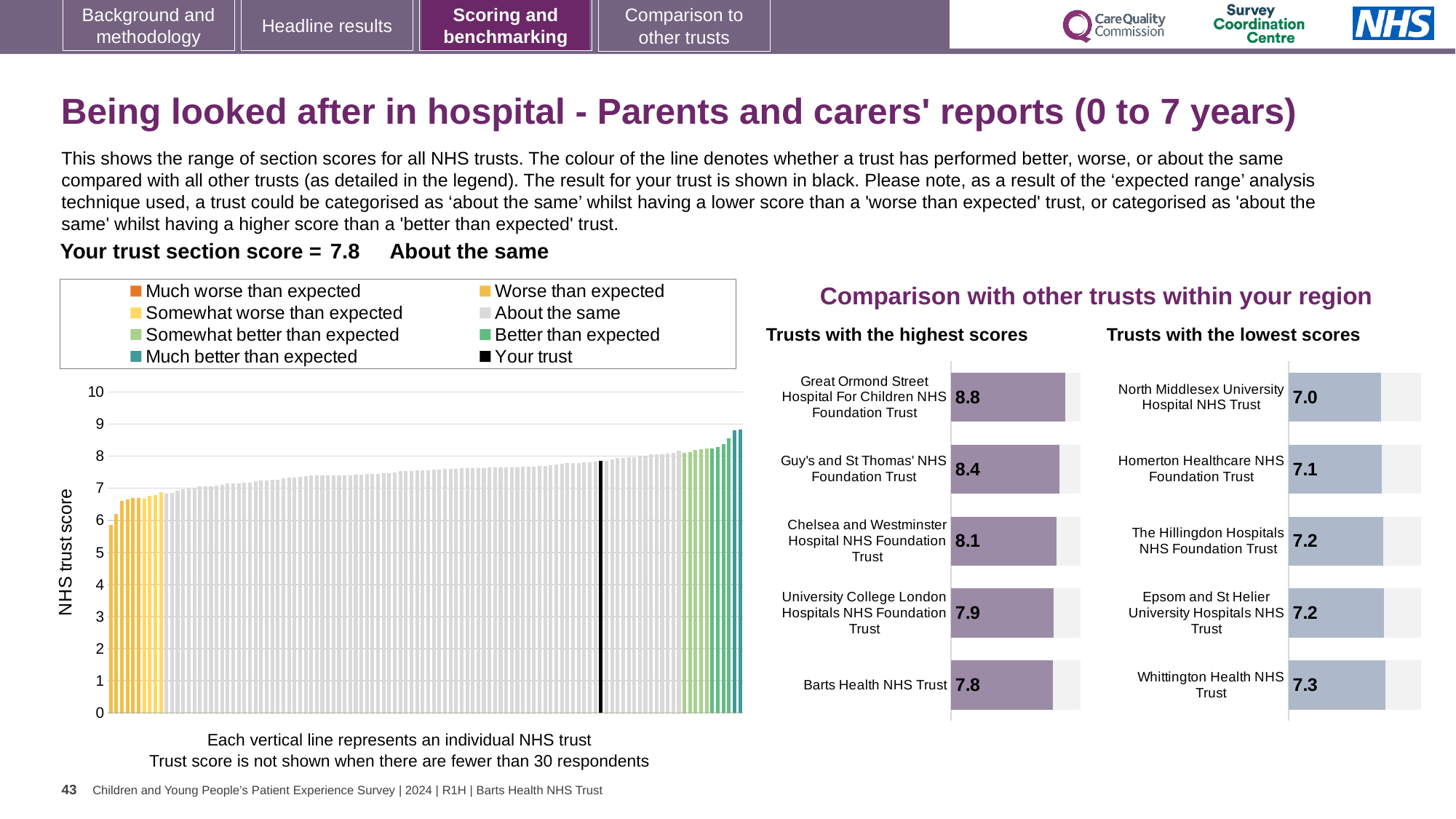
How many entries does the legend of the 'NHS trust score' chart on the left list? 8 In the 'Trusts with the lowest scores' chart, what is the score for Whittington Health NHS Trust? 7.3 In the 'NHS trust score' chart on the left, what colour is the bar for 'Your trust'? black What kind of chart is the 'NHS trust score' chart on the left? bar chart In the 'NHS trust score' chart on the left, is the value of the tallest bar greater or less than 8? greater In the 'NHS trust score' chart on the left, do the bar values rise or fall from left to right? rise In the 'Trusts with the lowest scores' chart, which trust has the lowest score? North Middlesex University Hospital NHS Trust In the 'Trusts with the highest scores' chart, what is the score for Great Ormond Street Hospital For Children NHS Foundation Trust? 8.8 In the 'Trusts with the highest scores' chart, what is the difference between the scores of Great Ormond Street Hospital For Children NHS Foundation Trust and Barts Health NHS Trust? 1.0 How many trusts are shown in the 'Trusts with the highest scores' chart? 5 In the 'Trusts with the lowest scores' chart, which has the larger score: Homerton Healthcare NHS Foundation Trust or The Hillingdon Hospitals NHS Foundation Trust? The Hillingdon Hospitals NHS Foundation Trust In the 'Trusts with the highest scores' chart, which trust has the highest score? Great Ormond Street Hospital For Children NHS Foundation Trust